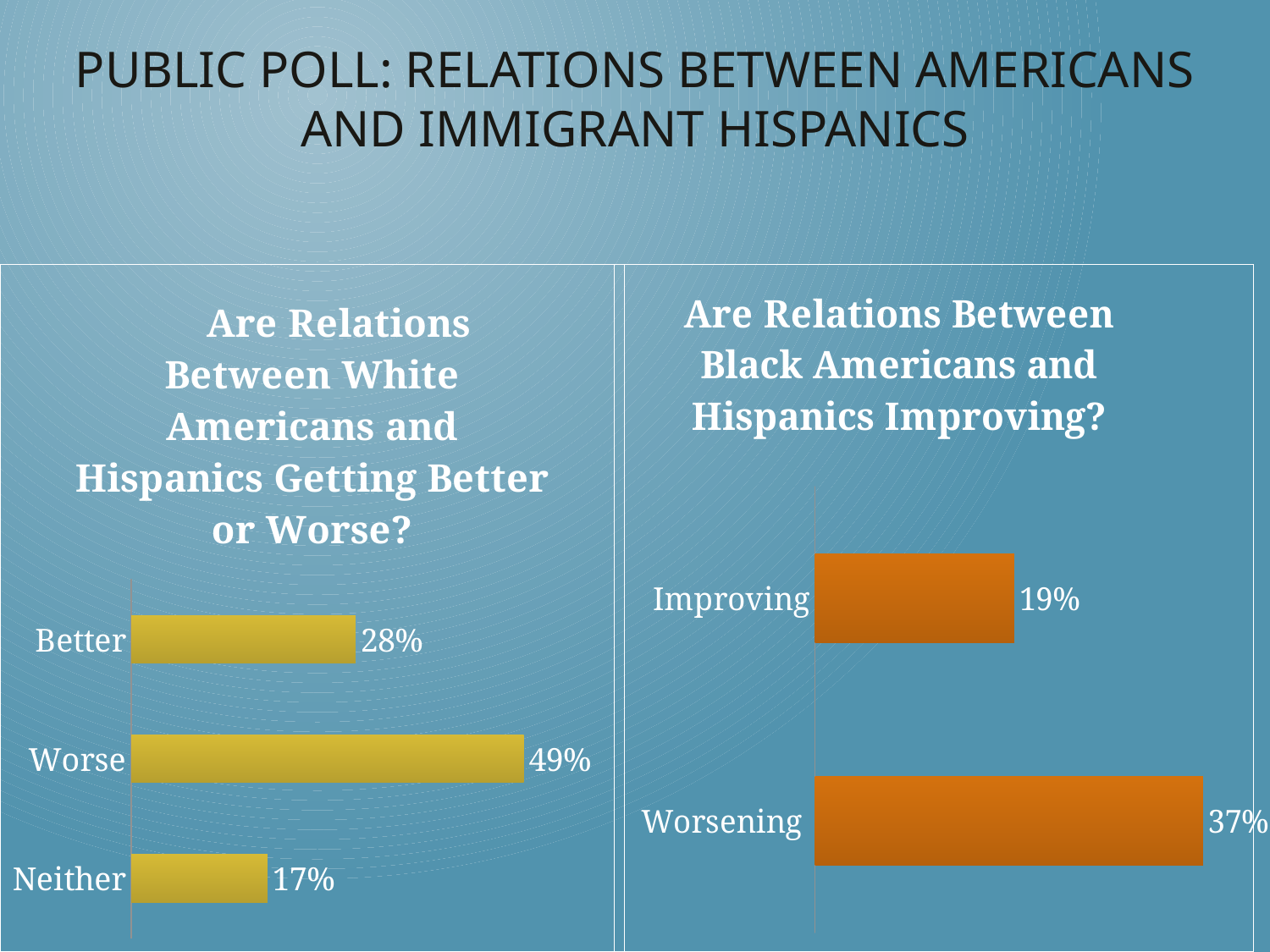
In the left chart (White Americans and Hispanics), how many response categories are shown? 3 In the right chart (Black Americans and Hispanics), what is the difference between the Worsening and Improving percentages? 18% In the left chart (White Americans and Hispanics), what is the difference between the Worse and Better percentages? 21% In the left chart (White Americans and Hispanics), what percentage answered Neither? 17% In the left chart (White Americans and Hispanics), which response has the highest percentage? Worse In the left chart (White Americans and Hispanics), which response has the lowest percentage? Neither In the right chart (Black Americans and Hispanics), which is larger, Improving or Worsening? Worsening In the right chart (Black Americans and Hispanics), what percentage said relations are worsening? 37% In the left chart (White Americans and Hispanics), what percentage said relations are getting worse? 49% In the left chart (White Americans and Hispanics), what percentage said relations are getting better? 28% What type of chart is used on the right side of the slide (Black Americans and Hispanics)? Bar chart In the right chart (Black Americans and Hispanics), what percentage said relations are improving? 19%